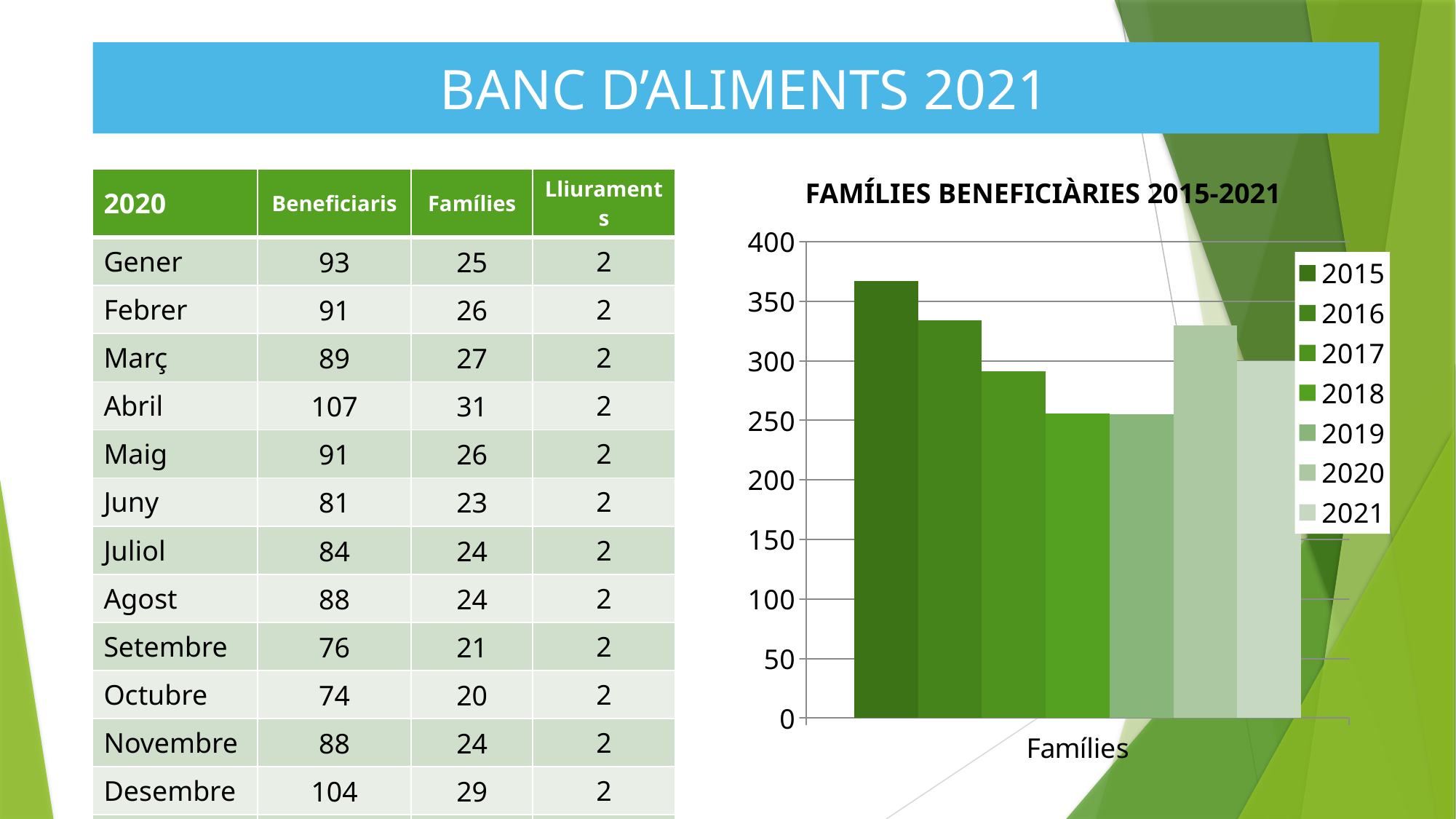
What is the title of the chart? FAMÍLIES BENEFICIÀRIES 2015-2021 What kind of chart is shown on the slide? bar chart Which is larger, the value for 2015 or the value for 2016? 2015 Do the bars rise or fall from 2015 to 2019? fall Is the value for 2021 greater or less than 250? greater Is the value for 2017 greater or less than 300? less Which is larger, the value for 2017 or the value for 2020? 2020 Which year has the highest bar in the chart? 2015 How many categories are shown on the x axis of the chart? 1 How many series does the legend of the chart list? 7 Is the value for 2020 greater or less than 350? less